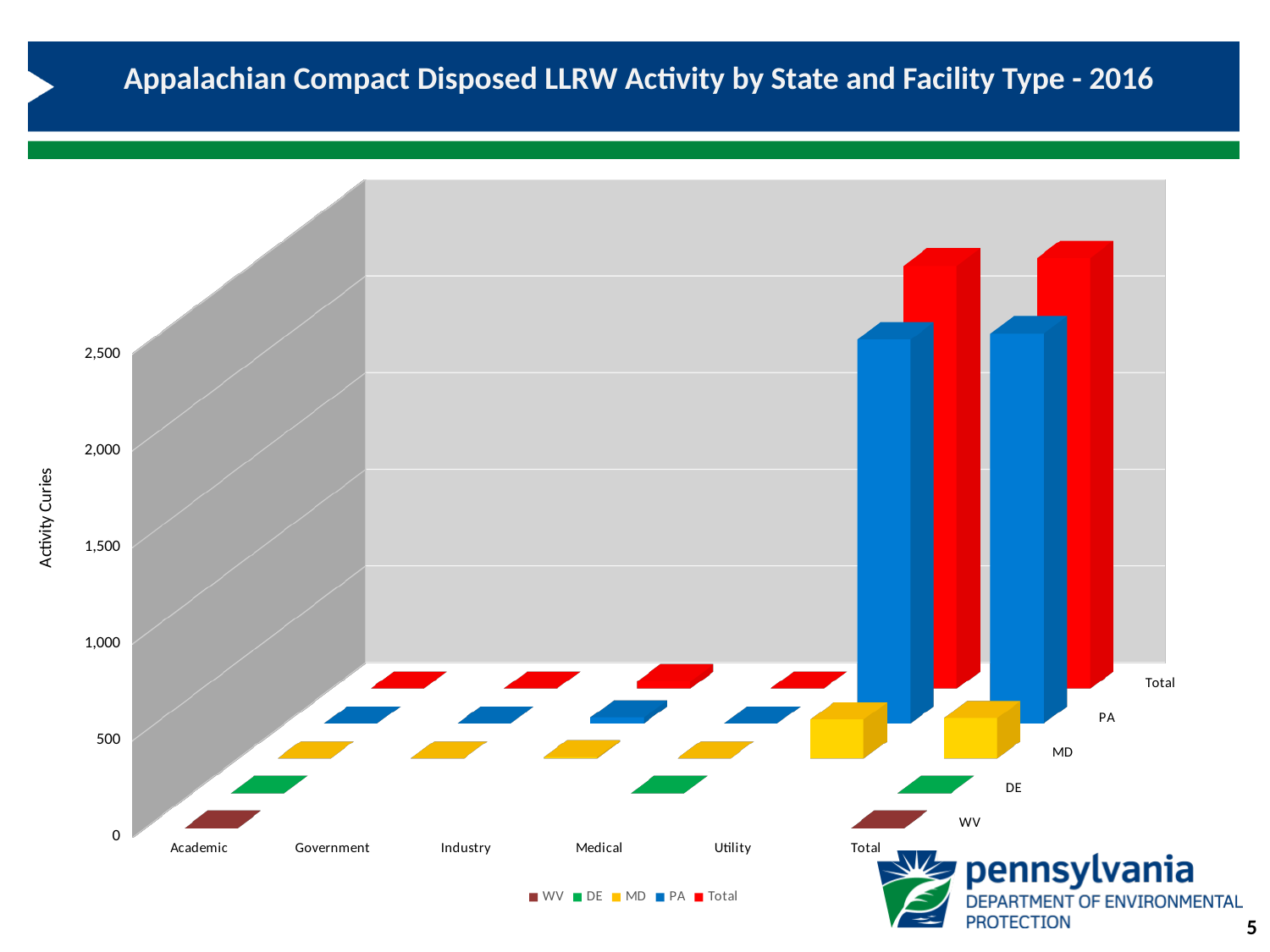
Which series has the tallest bar in the Total category? Total Among the state series (WV, DE, MD, PA), which has the tallest bar in the Total category? PA What kind of chart is shown on the slide? bar chart In the Total category, which is larger: the PA bar or the MD bar? PA What is the label on the vertical axis of the chart? Activity Curies Is the value for PA in the Total category greater or less than 1,000? greater What is the title of the chart? Appalachian Compact Disposed LLRW Activity by State and Facility Type - 2016 How many series does the legend list? 5 How many facility type categories are shown on the x axis? 6 Is the value for MD in the Total category greater or less than 500? less Is the value for the Total series in the Total category greater or less than 1,500? greater